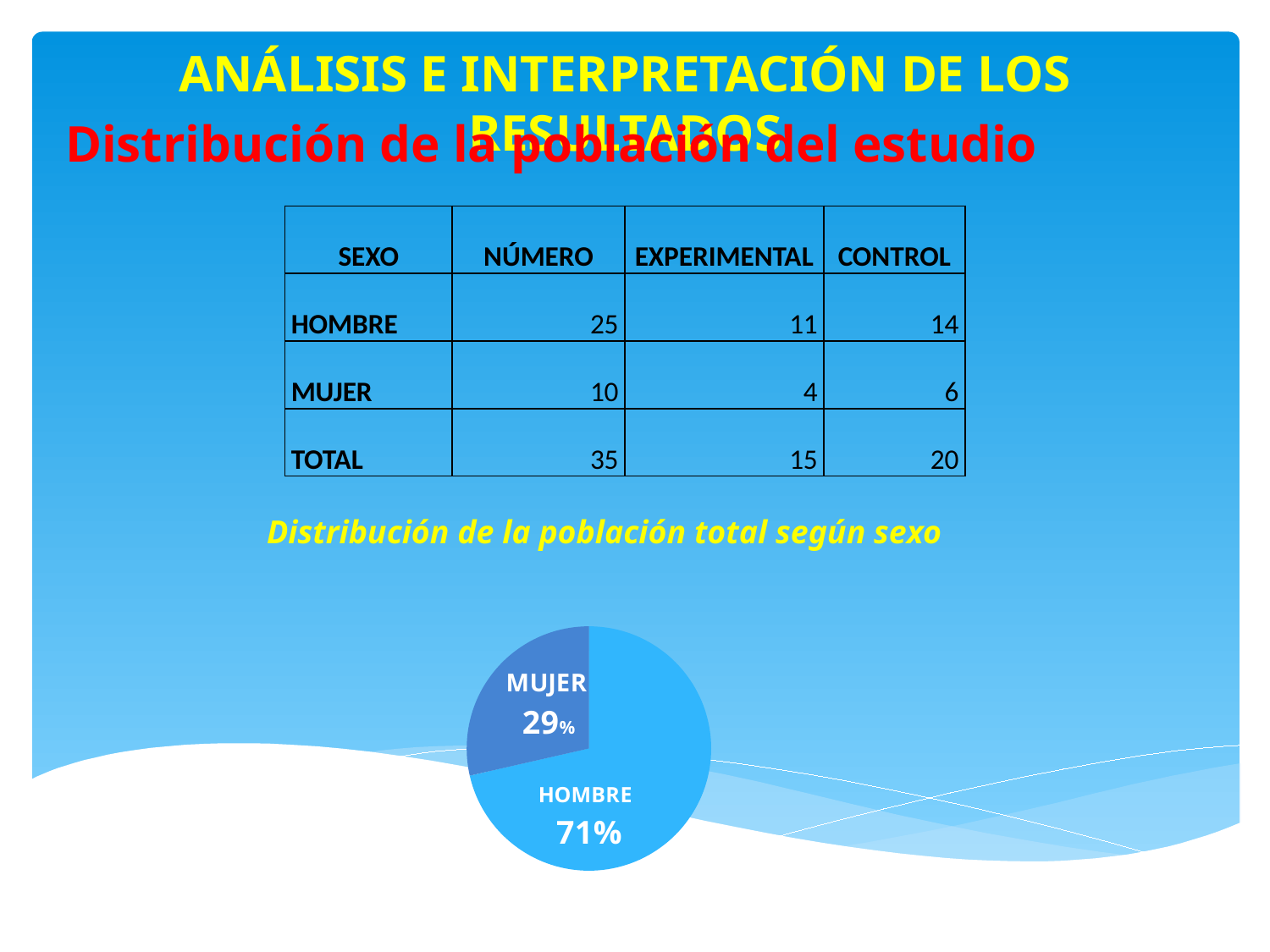
What is the difference in percentage points between the HOMBRE and MUJER slices of the pie chart? 42 Which slice of the pie chart is the largest? HOMBRE What is the share of the pie chart taken by the HOMBRE slice? 71% Is the share of the MUJER slice in the pie chart greater or less than 50%? less How many slices does the pie chart have? 2 What percentage of the pie chart does the MUJER slice represent? 29% What percentage of the pie chart does the HOMBRE slice represent? 71% What kind of chart is shown on the slide? pie chart Which slice of the pie chart is the smallest? MUJER Which is larger in the pie chart, the HOMBRE slice or the MUJER slice? HOMBRE What is the title shown above the pie chart? Distribución de la población total según sexo